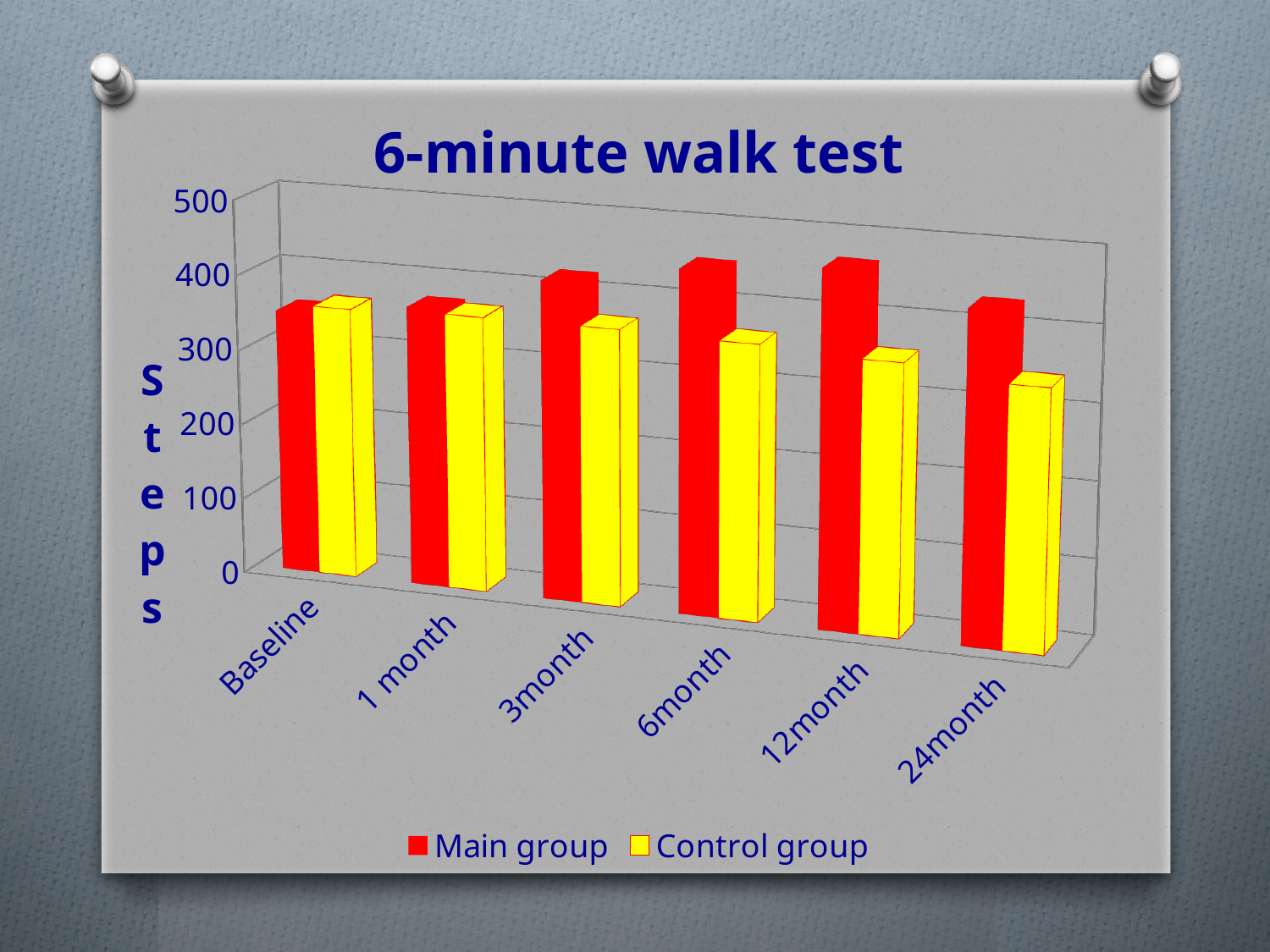
What is the title of the chart? 6-minute walk test Is the value for the Main group at 6month greater or less than 300? greater Is the value for the Control group at 12month greater or less than 200? greater How many series does the legend list? 2 For the Control group, which is larger, the value at Baseline or the value at 24month? Baseline Is the value for the Main group at Baseline greater or less than 500? less What kind of chart is shown on the slide? bar chart What label is shown on the vertical axis? Steps How many time-point categories are shown on the x axis? 6 At which time point is the Control group value lowest? 24month Do the Control group values rise or fall from Baseline to 24month? fall At 12month, which series has the larger value, Main group or Control group? Main group